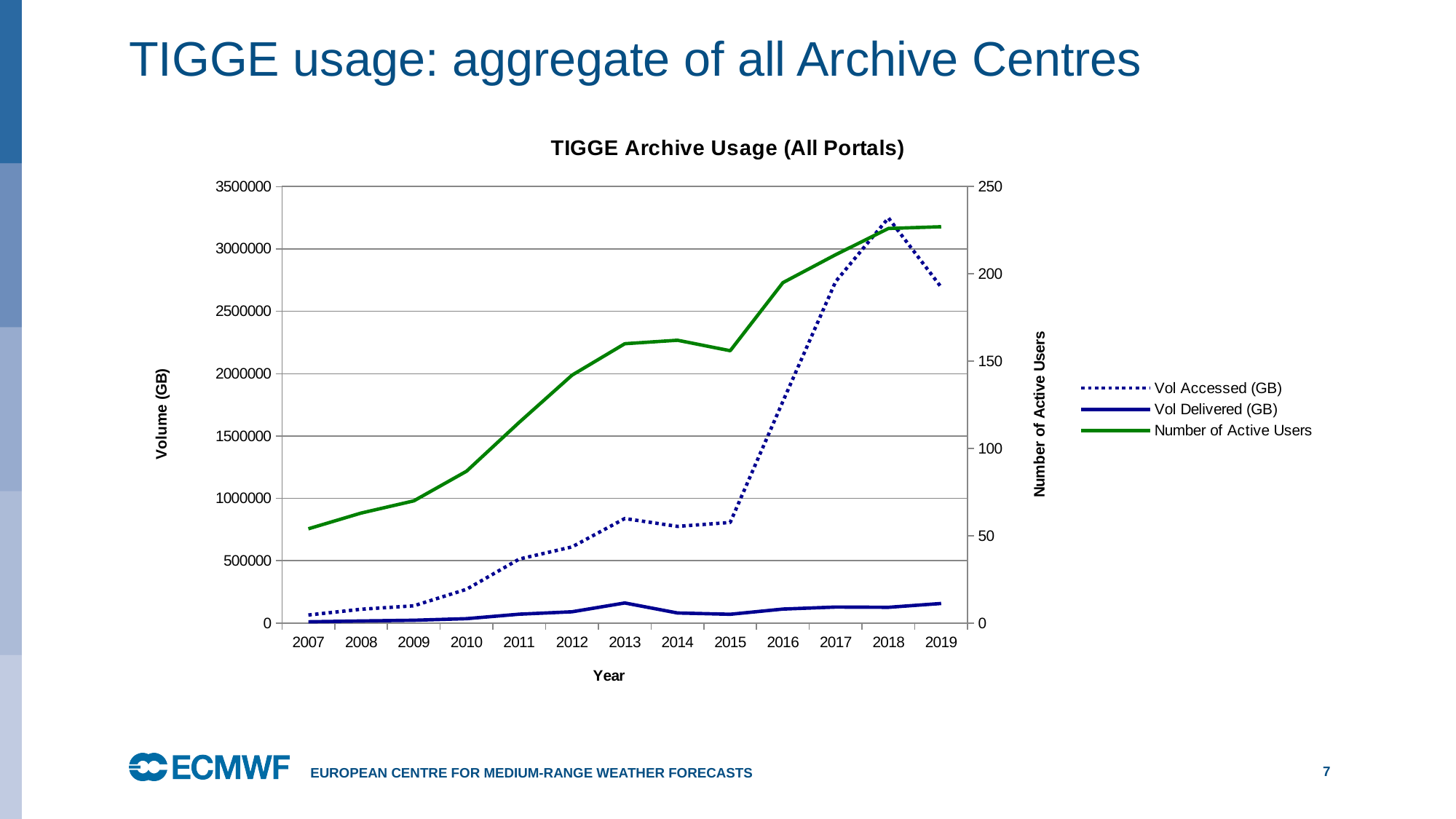
Is the value of Vol Accessed (GB) in 2018 greater or less than 3000000? greater Does the Number of Active Users rise or fall between 2007 and 2013? rise In which year is Vol Accessed (GB) at its lowest? 2007 Is the Number of Active Users in 2010 greater or less than 100? less How many series does the legend list? 3 Which is larger, Vol Accessed (GB) in 2018 or in 2019? 2018 In which year does Vol Accessed (GB) reach its highest value? 2018 What kind of chart is shown on the slide? line chart What is the title of the chart? TIGGE Archive Usage (All Portals) How many years are plotted along the x axis? 13 Is the value of Vol Accessed (GB) in 2015 greater or less than 1000000? less